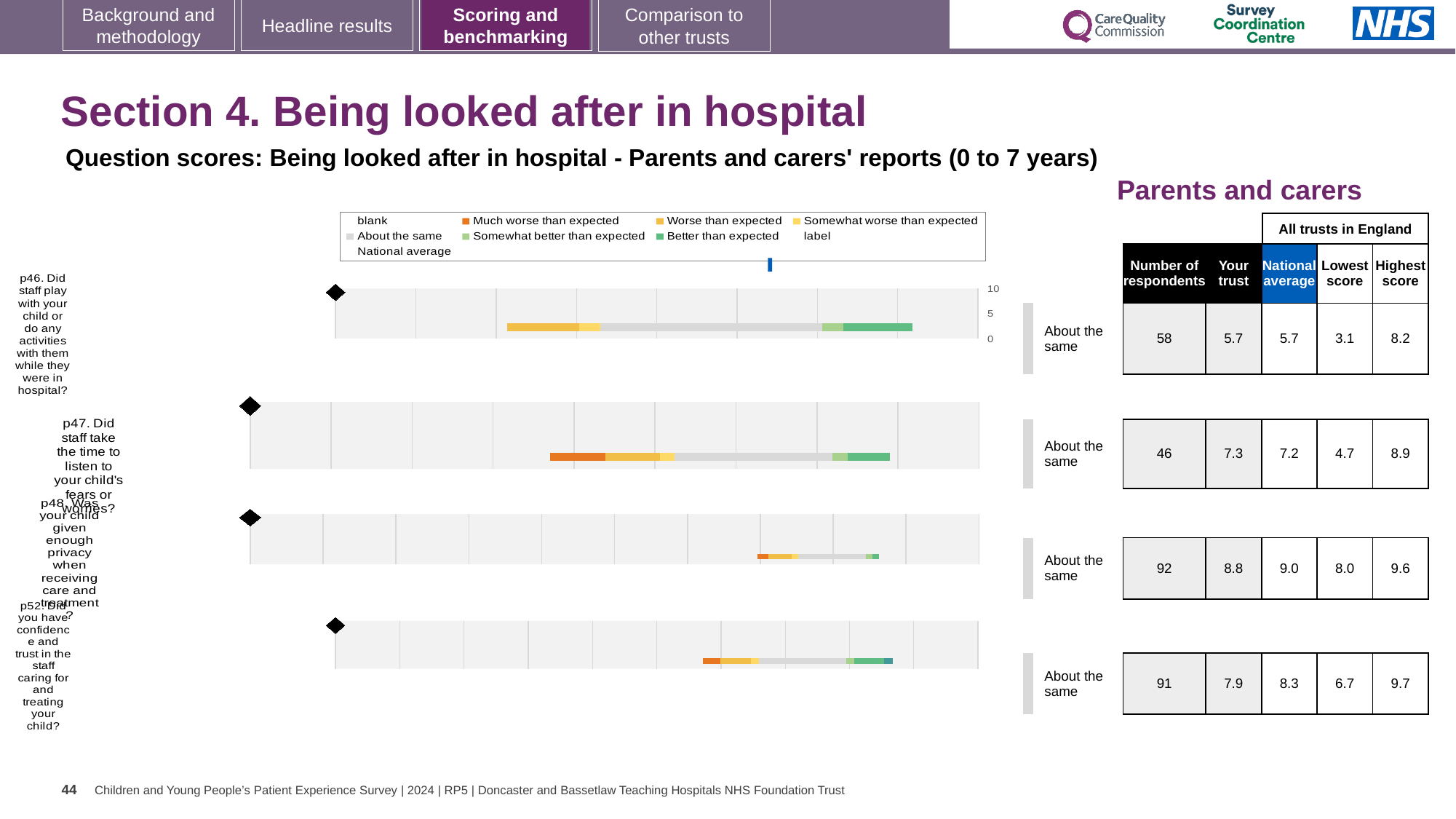
What is the national average score for p48 (Was your child given enough privacy when receiving care and treatment?)? 9.0 Which colour in the legend represents 'Better than expected'? green What is the difference between the national average and the 'Your trust' score for p52? 0.4 Which question has the fewest respondents on this slide? p47 Which question has the highest 'Your trust' score on this slide? p48 What kind of chart is used to show the question scores on this slide? bar chart How many respondents answered p46 (Did staff play with your child or do any activities with them while they were in hospital?)? 58 What is the highest tick value shown on the score axis of the p46 chart? 10 What is the highest score across all trusts in England for p52 (Did you have confidence and trust in the staff caring for and treating your child?)? 9.7 For p48, is the 'Your trust' score or the national average higher? National average What is the 'Your trust' score for p47 (Did staff take the time to listen to your child's fears or worries?)? 7.3 How many questions (p46, p47, p48, p52) have a score chart on this slide? 4